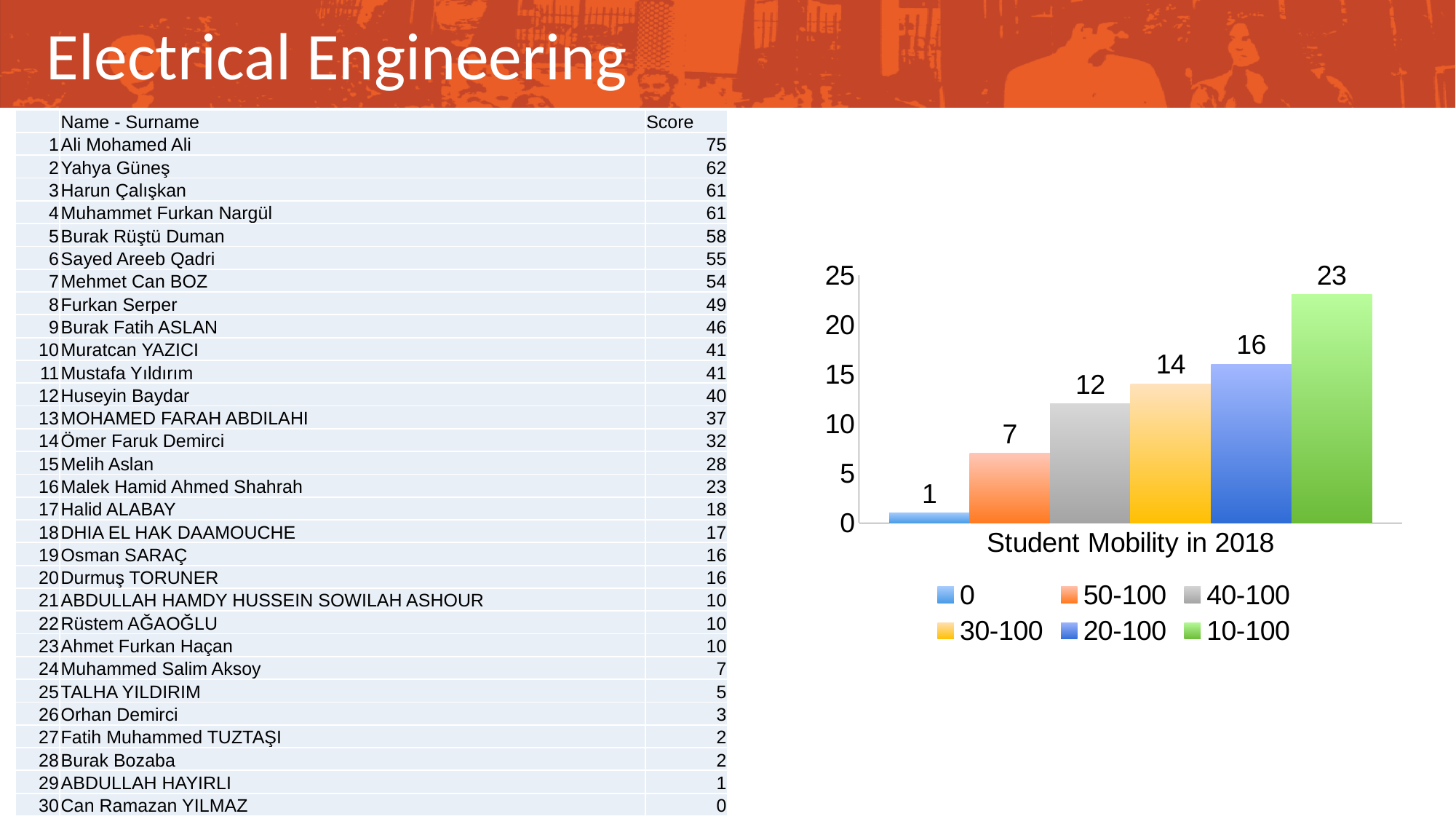
What is the value for the 30-100 series in the Student Mobility in 2018 chart? 14 What kind of chart is shown on the slide? bar chart How many series does the chart legend list? 6 Which is larger in the chart, the value for 40-100 or the value for 30-100? 30-100 What is the value for the 50-100 series in the Student Mobility in 2018 chart? 7 What is the difference between the values for 10-100 and 20-100 in the chart? 7 What colour is the bar for the 10-100 series in the chart? green What is the category label shown on the x axis of the chart? Student Mobility in 2018 What is the value for the 10-100 series in the Student Mobility in 2018 chart? 23 Which series has the lowest value in the Student Mobility in 2018 chart? 0 What is the value for the 0 series in the Student Mobility in 2018 chart? 1 Which series has the highest value in the Student Mobility in 2018 chart? 10-100